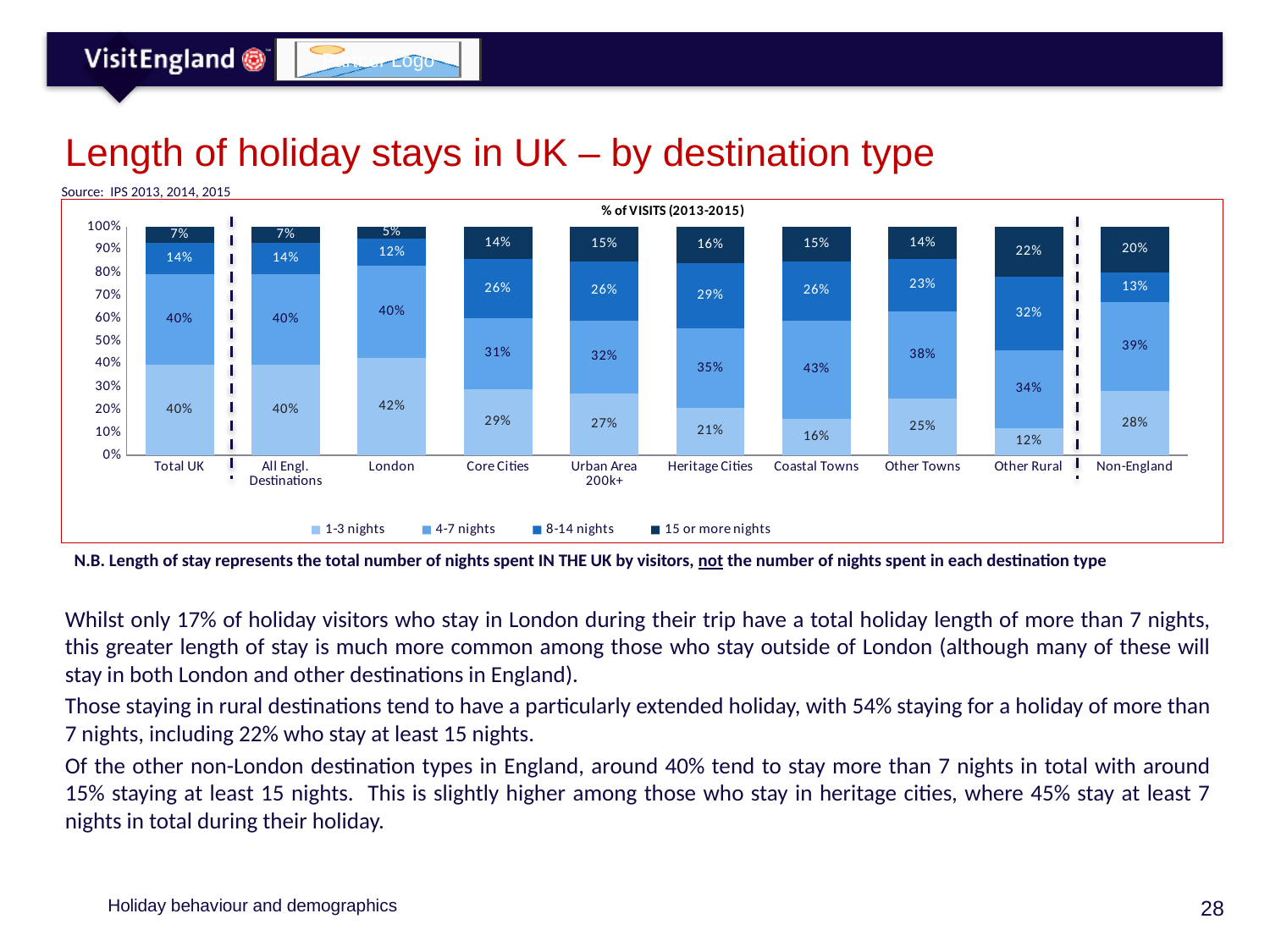
What is the difference between the 1-3 nights share for Total UK and for Other Rural? 28 percentage points Which destination type has the lowest share of 15 or more nights visits? London What percentage of visits to London are 1-3 nights? 42% What type of chart is shown on the slide? Stacked bar chart Which destination type has the highest share of 1-3 night visits? London Which is larger: the 8-14 nights share for Other Rural or for Non-England? Other Rural Which destination type has the lowest share of 1-3 night visits? Other Rural How many length-of-stay series does the legend list? 4 What percentage of visits to Other Rural destinations are 15 or more nights? 22% What percentage of visits to Coastal Towns are 4-7 nights? 43% What percentage of visits to Heritage Cities are 8-14 nights? 29% How many destination types are shown on the x axis? 10